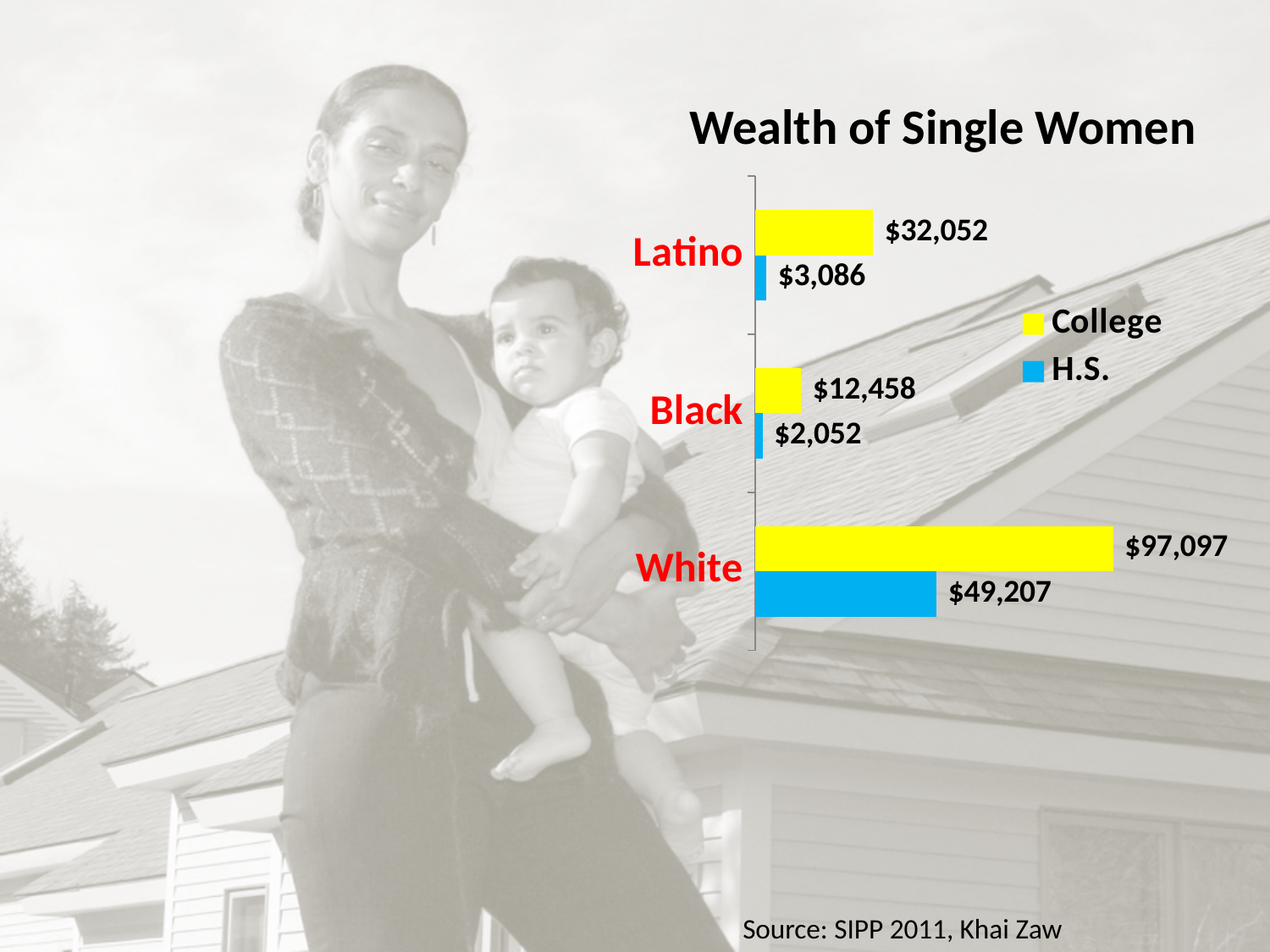
What is the difference between the College and H.S. wealth values for White single women? $47,890 Which is larger: the H.S. value for Latino single women or the H.S. value for Black single women? Latino How many groups are shown on the chart? 3 What is the difference between the College wealth values for Latino and Black single women? $19,594 What is the College wealth value for Latino single women? $32,052 What is the H.S. wealth value for Black single women? $2,052 Which group has the highest College wealth value? White How many series does the legend list? 2 Which group has the lowest H.S. wealth value? Black What is the College wealth value for Black single women? $12,458 What is the H.S. wealth value for White single women? $49,207 What type of chart is shown on the slide? Bar chart